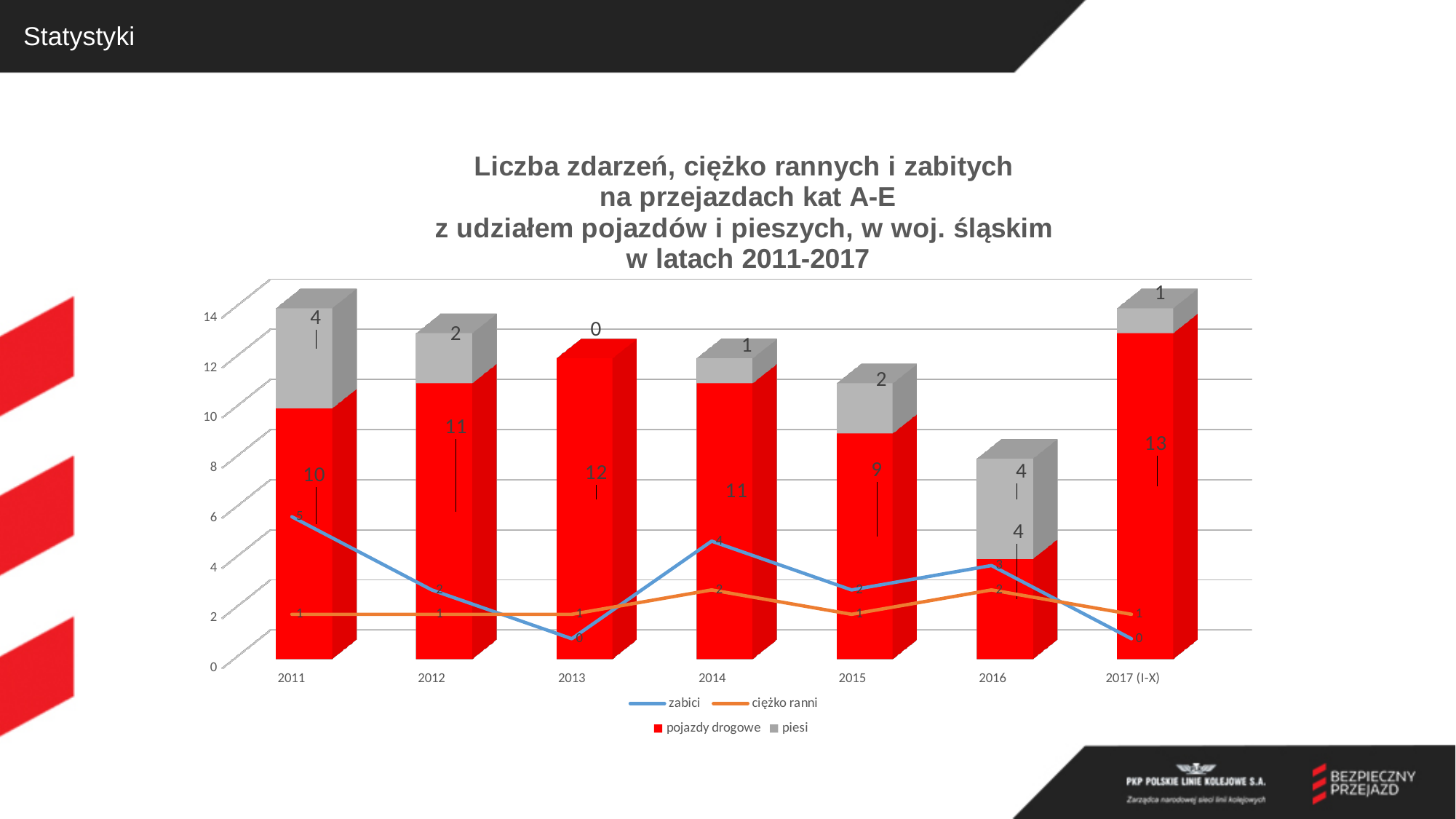
In which year is the value for pojazdy drogowe the highest? 2017 (I-X) What is the total of the stacked bar for 2011 (pojazdy drogowe plus piesi)? 14 What is the difference between the pojazdy drogowe values for 2017 (I-X) and 2016? 9 Which is larger, the zabici value for 2011 or for 2016? 2011 What is the value for pojazdy drogowe in 2013? 12 How many series does the legend list? 4 How many years are shown on the x axis? 7 In which year is the value for pojazdy drogowe the lowest? 2016 What is the value for ciężko ranni in 2016? 2 Which series is shown as a blue line? zabici What is the value for piesi in 2011? 4 What is the value for zabici in 2014? 4